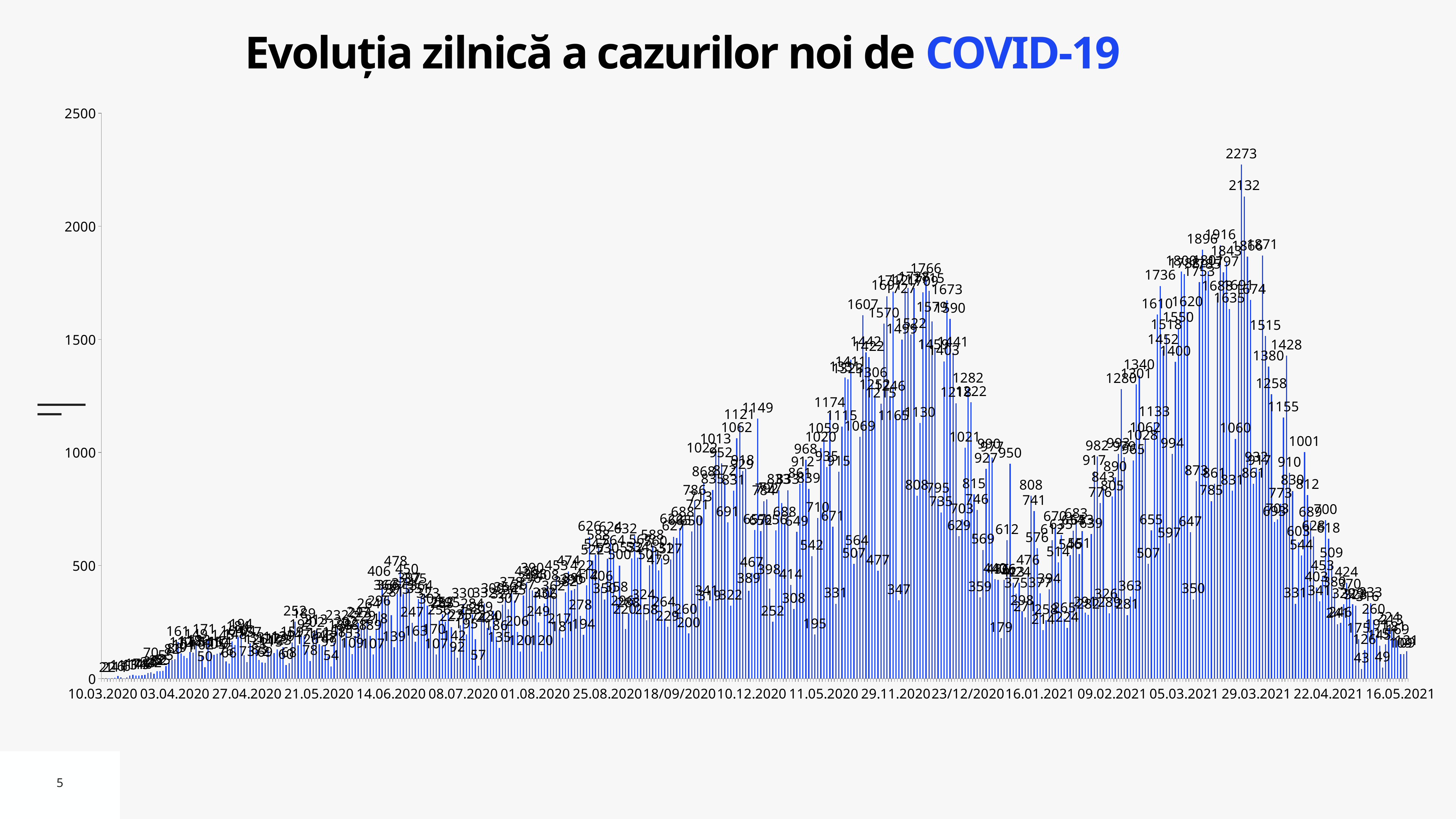
Do the values generally rise or fall between 10.03.2020 and 14.06.2020? rise What is the highest labelled value in the wave around 29.11.2020? 1766 What is the difference between the two highest labelled values, 2273 and 2132? 141 What is the last date label shown on the x axis? 16.05.2021 Is the peak value of the wave around 29.11.2020 greater or less than 1500? greater Which wave has the higher peak: the one around 29.11.2020 or the one around 29.03.2021? 29.03.2021 Do the values generally rise or fall between the peak near 29.03.2021 and 16.05.2021? fall What kind of chart is shown on the slide? bar chart What is the title of the chart? Evoluția zilnică a cazurilor noi de COVID-19 What is the second highest daily value labelled on the chart, next to the 2273 peak? 2132 Is the highest bar on the chart greater or less than 2000? greater What is the highest daily value labelled on the chart? 2273